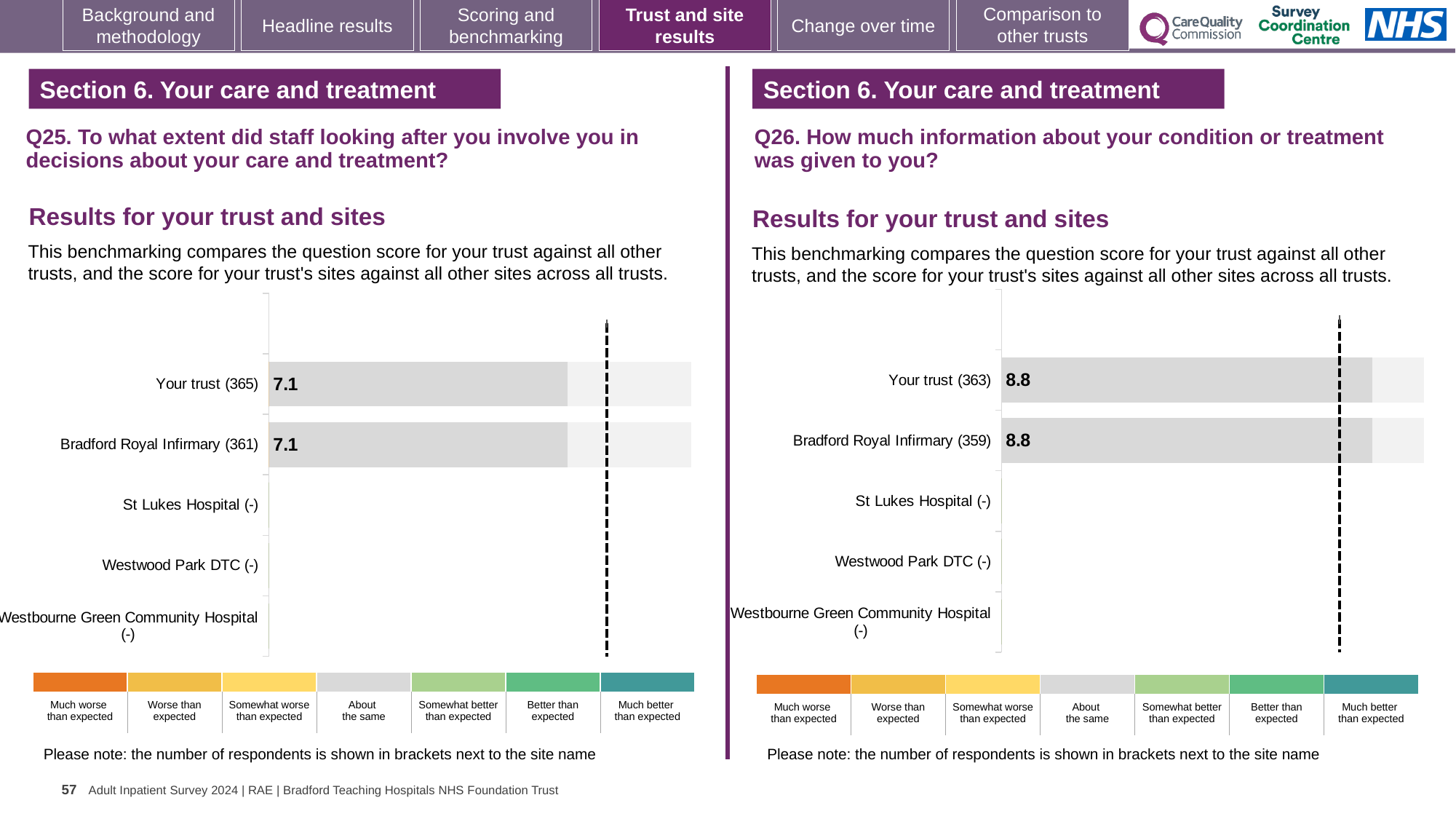
On the Q25 chart (left), what is the score for Bradford Royal Infirmary? 7.1 On the Q25 chart (left), what is the difference between the score for Your trust and the score for Bradford Royal Infirmary? 0 On the Q26 chart (right), what is the score for Your trust? 8.8 On the Q26 chart (right), what is the difference between the score for Your trust and the score for Bradford Royal Infirmary? 0 On the Q26 chart (right), which category is listed last (at the bottom) of the chart? Westbourne Green Community Hospital (-) How many site/trust categories are listed on the Q26 chart (right)? 5 What kind of chart is used on the Q25 chart (left)? Bar chart On the Q26 chart (right), what is the score for Bradford Royal Infirmary? 8.8 On the Q25 chart (left), how many respondents are shown in brackets for Your trust? 365 On the Q26 chart (right), how many respondents are shown in brackets for Bradford Royal Infirmary? 359 On the Q25 chart (left), what is the score for Your trust? 7.1 How many site/trust categories are listed on the Q25 chart (left)? 5